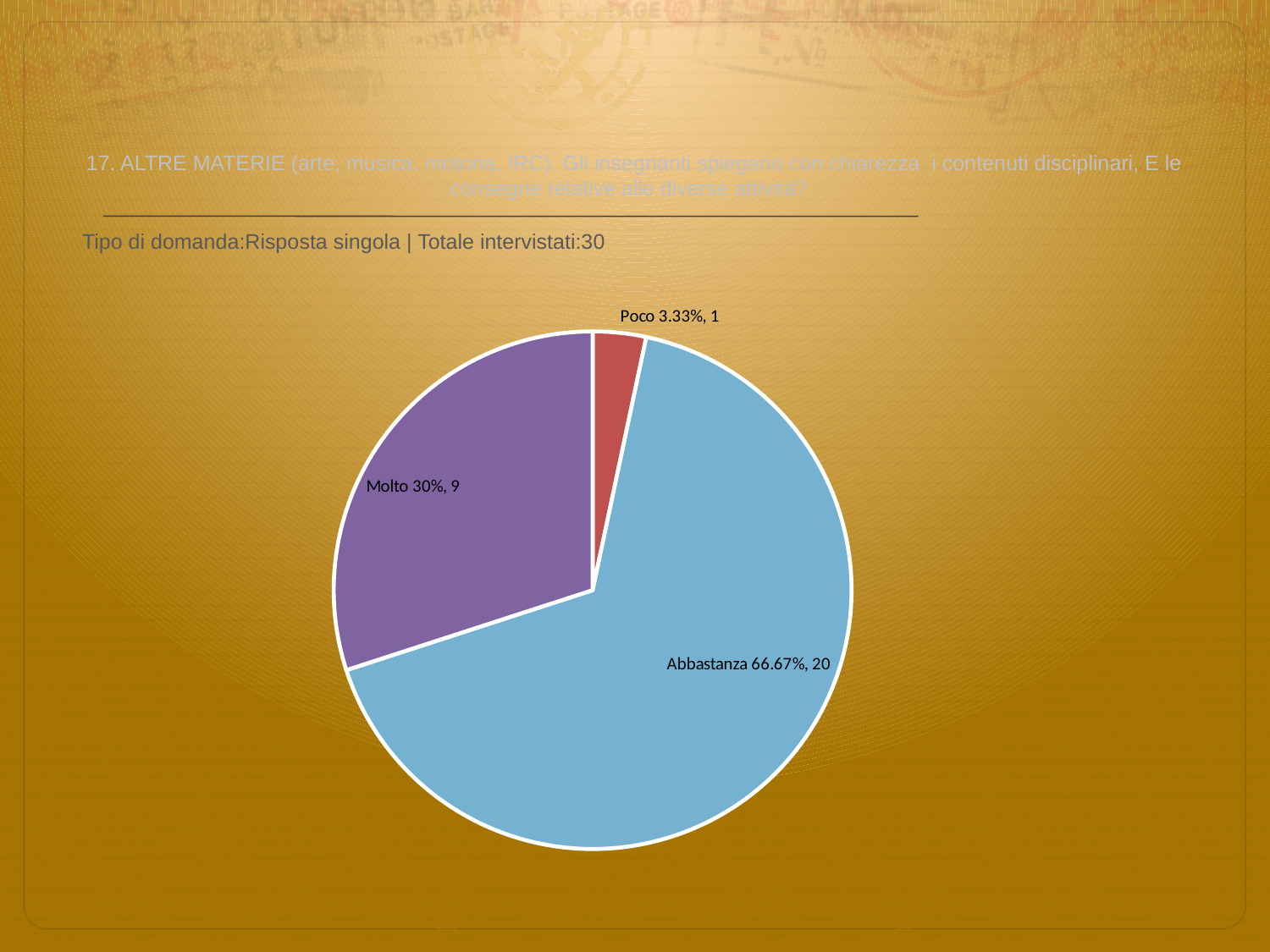
How many respondents answered Abbastanza? 20 How many slices does the pie chart have? 3 What is the difference in respondent count between Abbastanza and Molto? 11 Which category has the smallest slice? Poco What percentage share does the Poco slice have? 3.33% Which is larger, the Molto slice or the Poco slice? Molto Which category has the largest slice? Abbastanza How many respondents answered Molto? 9 How many respondents answered Poco? 1 What percentage share does the Molto slice have? 30% What kind of chart is shown on the slide? pie chart What percentage share does the Abbastanza slice have? 66.67%